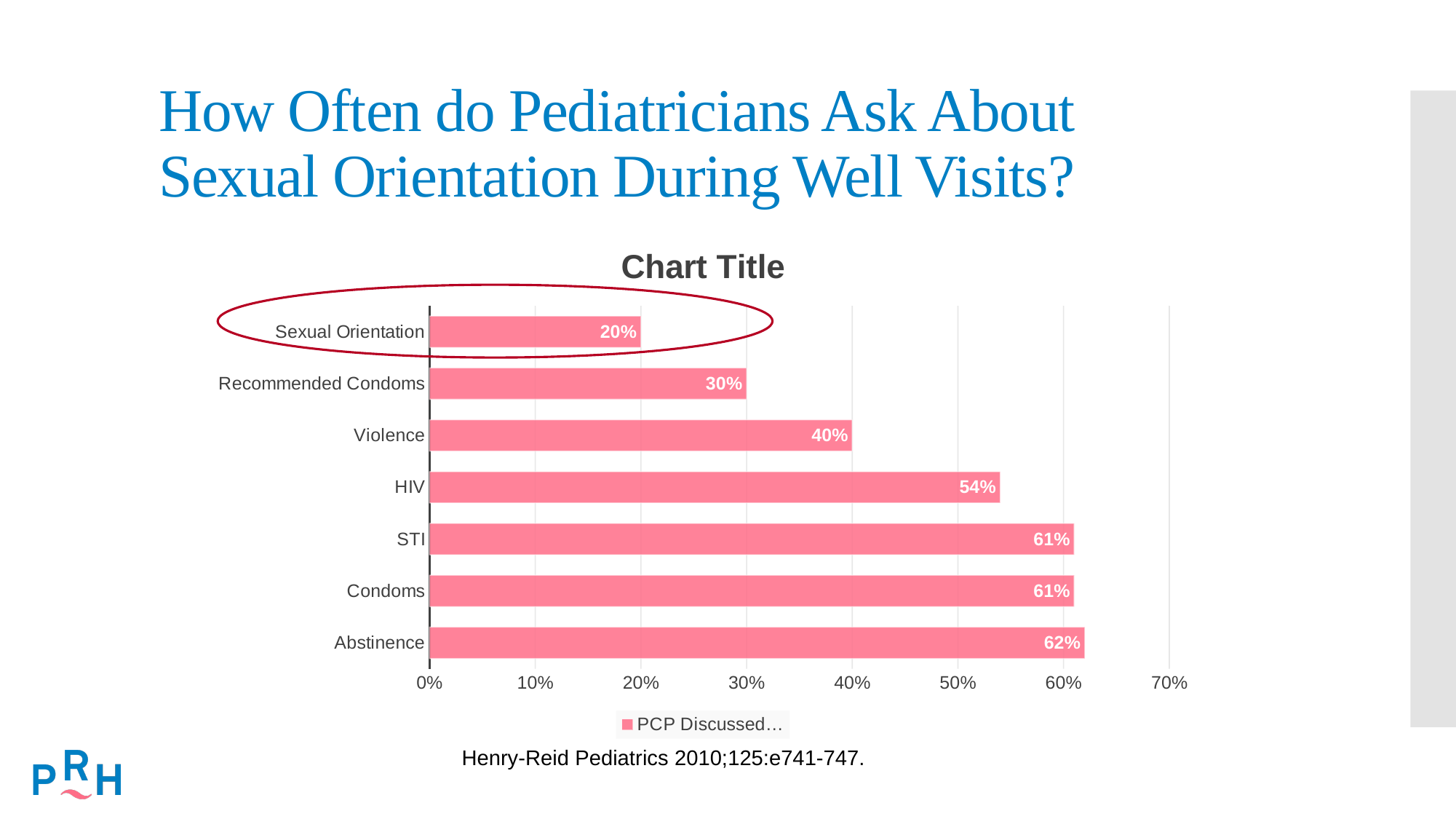
What percentage is shown for Sexual Orientation? 20% How many series does the legend list? 1 Which category has the highest value? Abstinence What kind of chart is shown on the slide? Bar chart What is the title printed above the chart? Chart Title What is the difference between the values for HIV and Recommended Condoms? 24% What is the value for Violence? 40% How many categories are shown in the chart? 7 What is the value for HIV? 54% Which is larger, the value for Violence or the value for HIV? HIV What is the difference between the values for Abstinence and Sexual Orientation? 42% Which category has the lowest value? Sexual Orientation